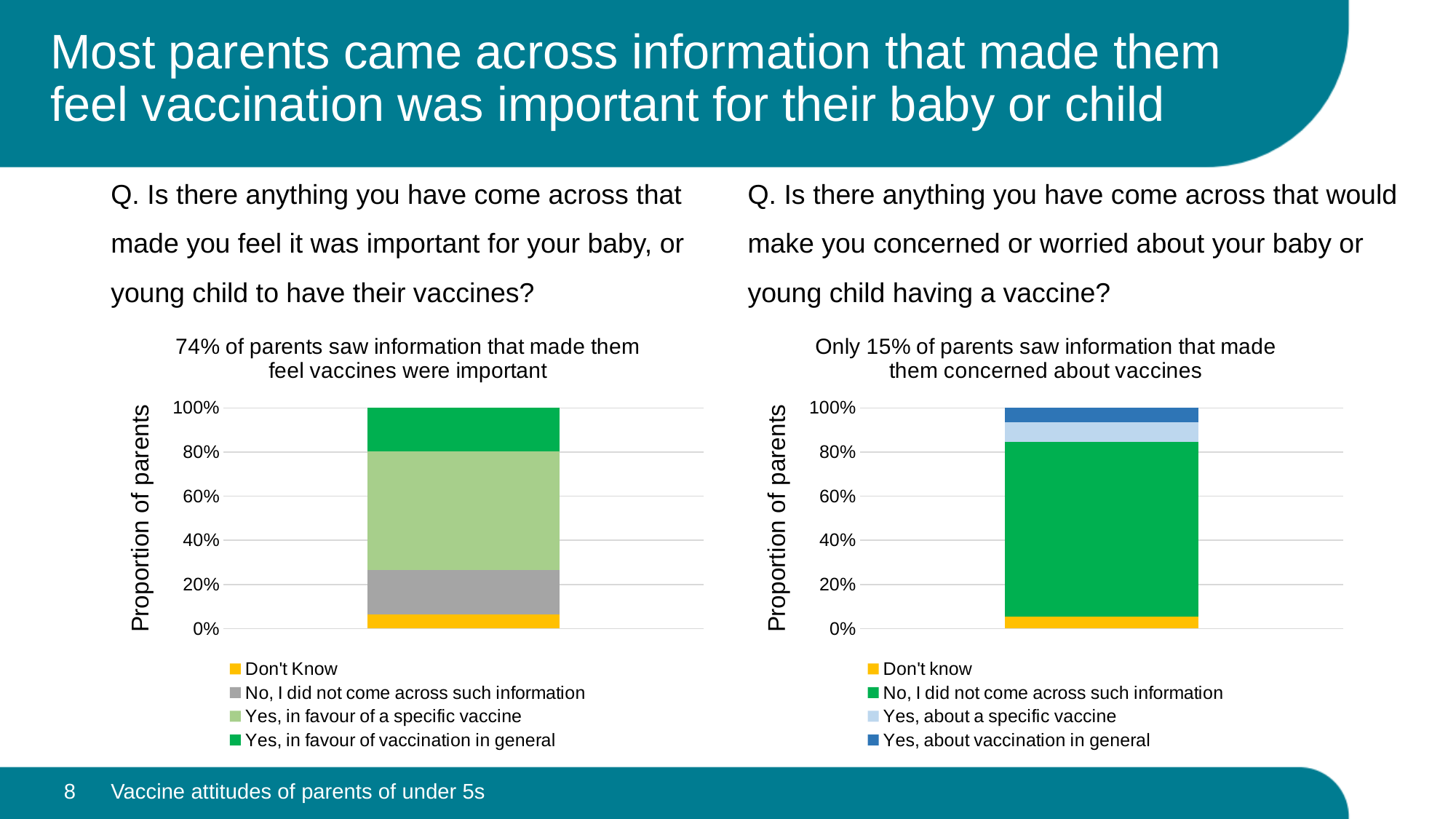
What is the title of the right chart? Only 15% of parents saw information that made them concerned about vaccines In the left chart, which is larger: the share for "Yes, in favour of a specific vaccine" or the share for "Don't Know"? Yes, in favour of a specific vaccine In the left chart, which series takes up the smallest share of the bar? Don't Know How many series does the legend of the right chart list? 4 In the right chart, which series takes up the largest share of the bar? No, I did not come across such information In the right chart, is the share for "Yes, about vaccination in general" greater or less than 20%? less How many series does the legend of the left chart list? 4 What is the y-axis label of the left chart? Proportion of parents In the right chart, is the share for "No, I did not come across such information" greater or less than 60%? greater What kind of chart is the left chart titled "74% of parents saw information that made them feel vaccines were important"? Stacked bar chart In the left chart, is the share for "Yes, in favour of a specific vaccine" greater or less than 40%? greater In the left chart, which series takes up the largest share of the bar? Yes, in favour of a specific vaccine